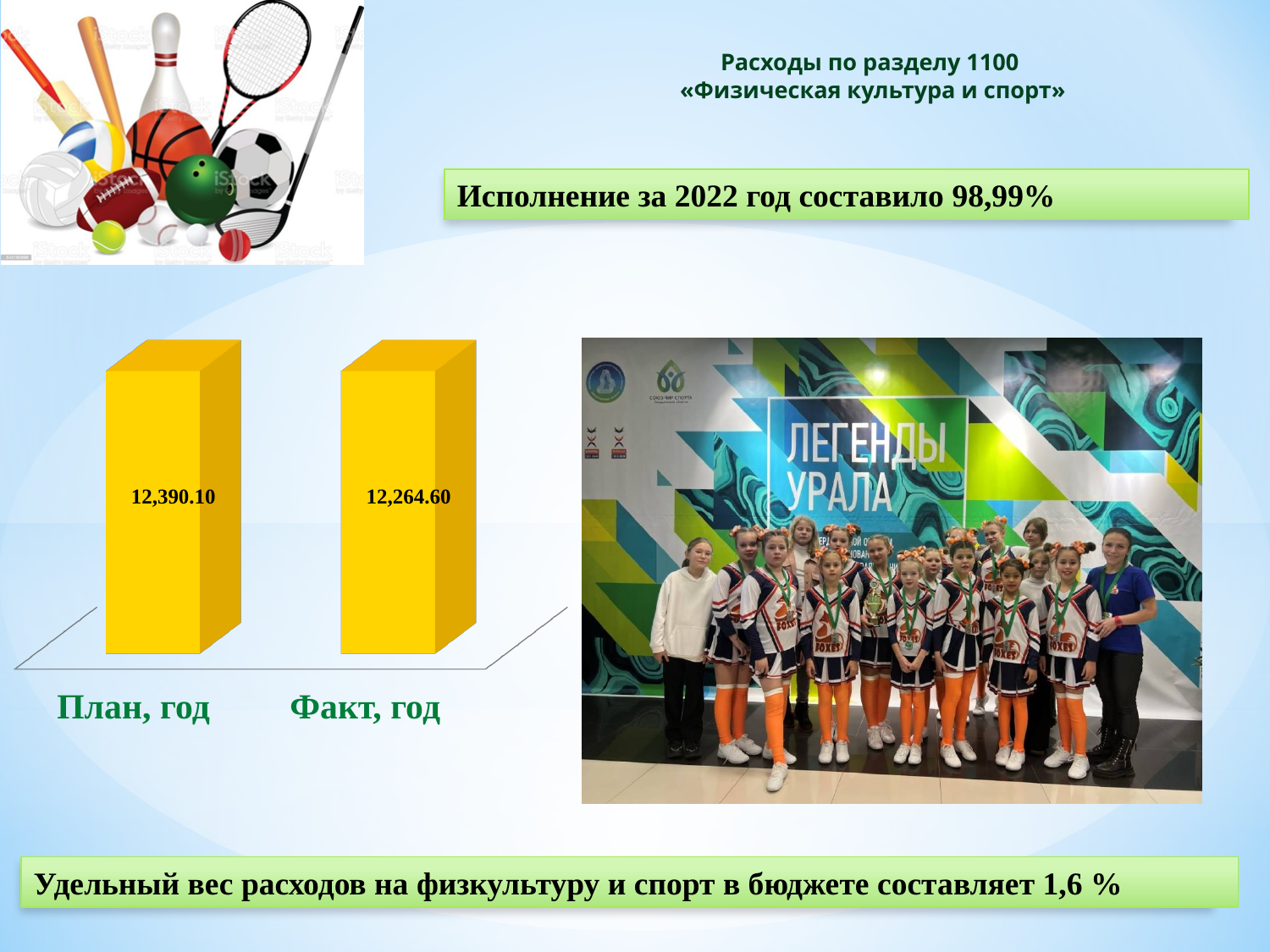
Which category has the higher value, План, год or Факт, год? План, год What is the value shown for Факт, год? 12,264.60 What kind of chart is shown on the slide? Bar chart What is the difference between the values for План, год and Факт, год? 125.50 Which category has the lowest value in the chart? Факт, год What are the two category labels on the chart's x axis? План, год and Факт, год How many bars are plotted in the chart? 2 What is the value shown for План, год? 12,390.10 What colour are the bars in the chart? Yellow Which category has the highest value in the chart? План, год Do the values fall or rise from План, год to Факт, год? Fall